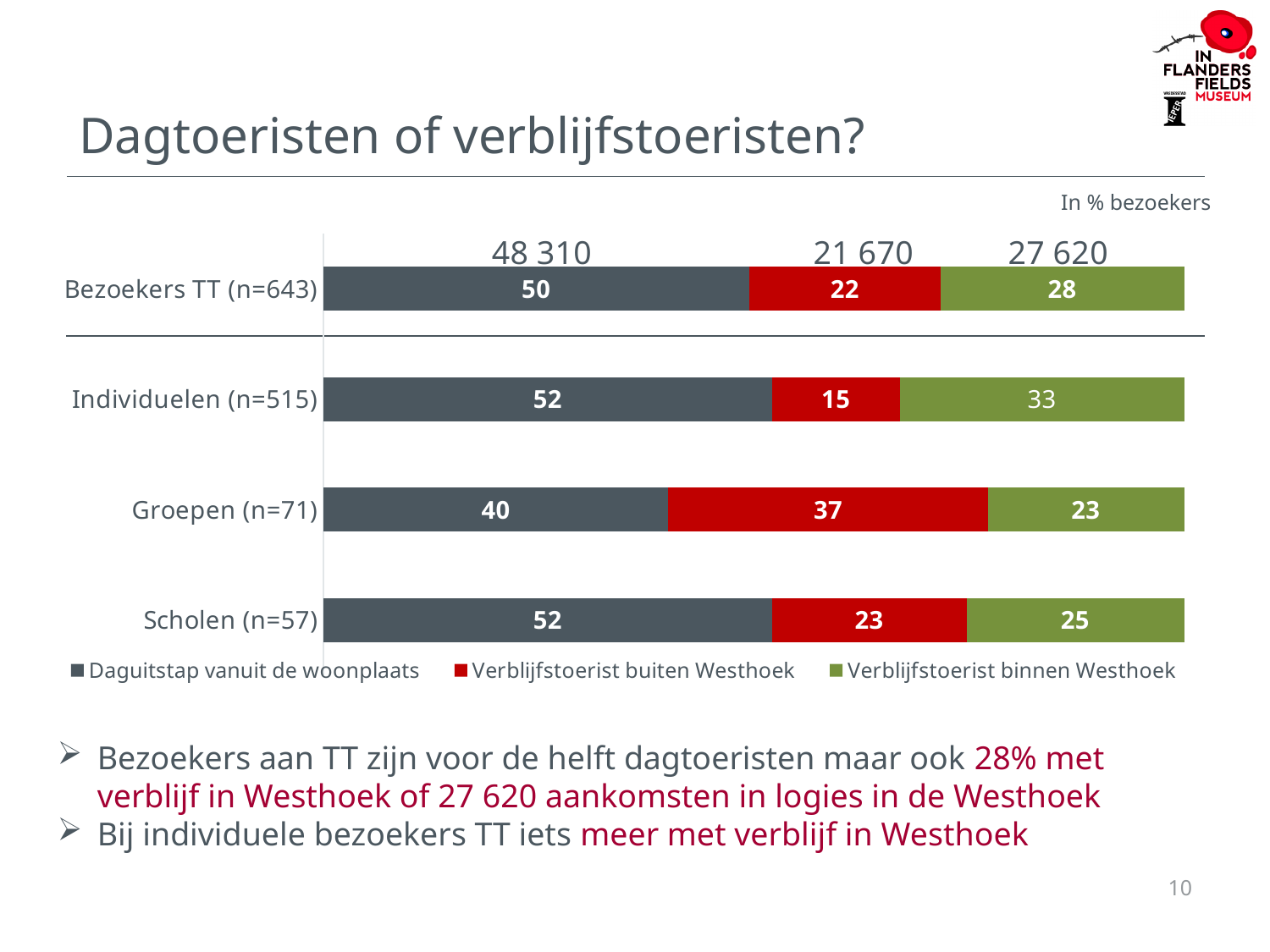
What is the value for Verblijfstoerist buiten Westhoek for Individuelen (n=515)? 15 Which category has the lowest value for Daguitstap vanuit de woonplaats? Groepen (n=71) Which is larger for Bezoekers TT (n=643): Verblijfstoerist buiten Westhoek or Verblijfstoerist binnen Westhoek? Verblijfstoerist binnen Westhoek What absolute number is printed above the Verblijfstoerist binnen Westhoek segment for Bezoekers TT (n=643)? 27 620 What is the difference between the Verblijfstoerist binnen Westhoek values for Individuelen (n=515) and Groepen (n=71)? 10 What kind of chart is shown on the slide? Stacked bar chart Which category has the highest value for Verblijfstoerist buiten Westhoek? Groepen (n=71) How many series does the legend list? 3 What is the value for Daguitstap vanuit de woonplaats for Groepen (n=71)? 40 What is the total of the stacked bar for Scholen (n=57)? 100 How many categories are plotted on the chart? 4 What is the value for Verblijfstoerist binnen Westhoek for Scholen (n=57)? 25